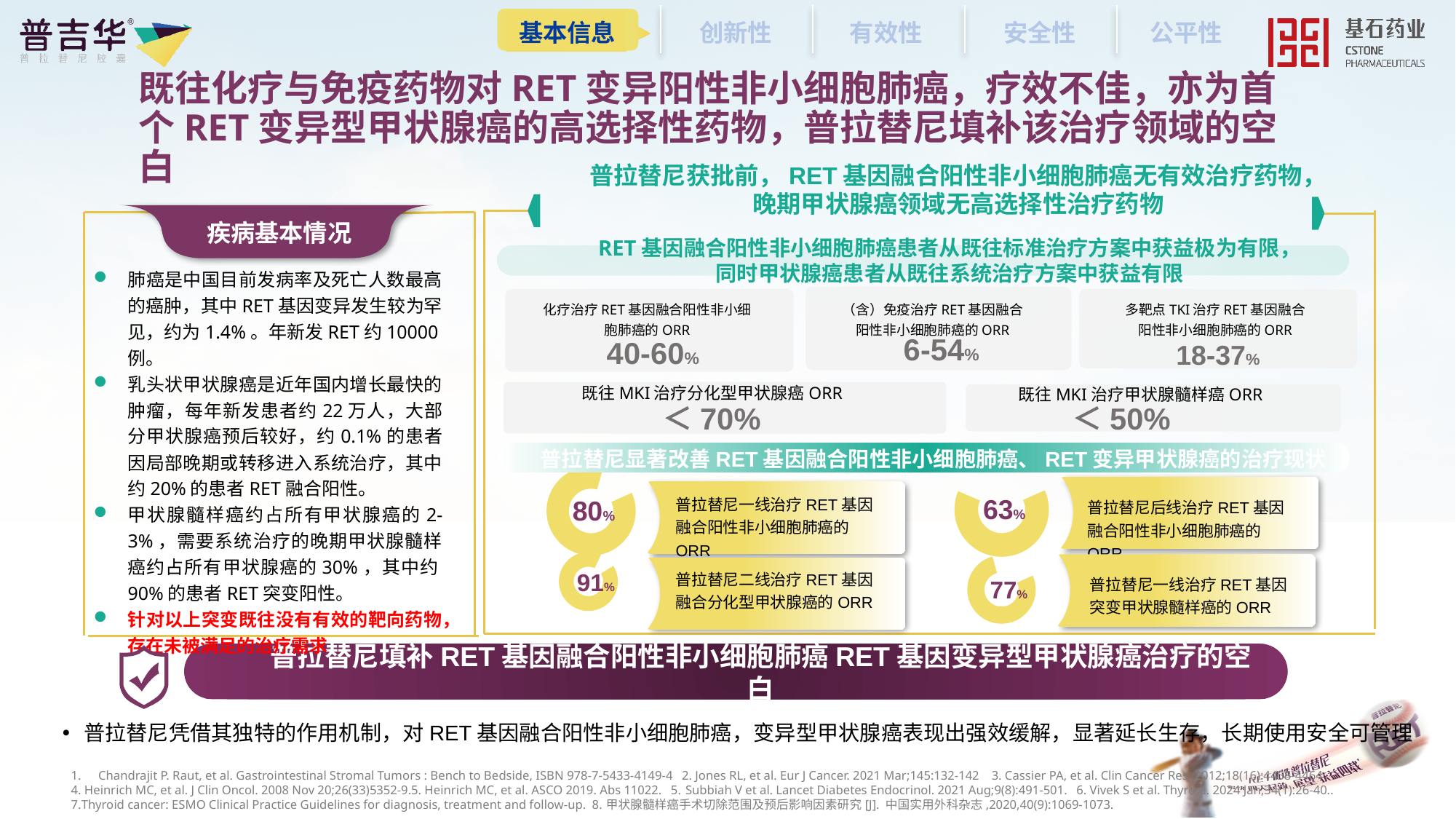
How many donut charts are shown in the lower panel of the slide? 4 What ORR value is shown in the donut chart for 普拉替尼二线治疗 RET 基因融合分化型甲状腺癌? 91% What is the difference in ORR between the first-line (一线) and later-line (后线) donut charts for RET 基因融合阳性非小细胞肺癌? 17% Which is larger: the ORR in the donut chart for 普拉替尼一线治疗 RET 突变甲状腺髓样癌 or the one for 普拉替尼后线治疗 RET 基因融合阳性非小细胞肺癌? 普拉替尼一线治疗 RET 突变甲状腺髓样癌 What ORR value is shown in the donut chart for 普拉替尼一线治疗 RET 基因融合阳性非小细胞肺癌? 80% Among the four donut charts in the lower panel, which treatment setting has the lowest ORR? 普拉替尼后线治疗 RET 基因融合阳性非小细胞肺癌 What ORR value is shown in the donut chart for 普拉替尼后线治疗 RET 基因融合阳性非小细胞肺癌? 63% What colour are the filled segments of the four ORR donut charts? Yellow What kind of chart is used to display the 80%, 91%, 63% and 77% ORR values? Donut (pie) chart Among the four donut charts in the lower panel, which treatment setting has the highest ORR? 普拉替尼二线治疗 RET 基因融合分化型甲状腺癌 What ORR value is shown in the donut chart for 普拉替尼一线治疗 RET 突变甲状腺髓样癌? 77% What is the difference in ORR between the 91% donut chart and the 77% donut chart? 14%